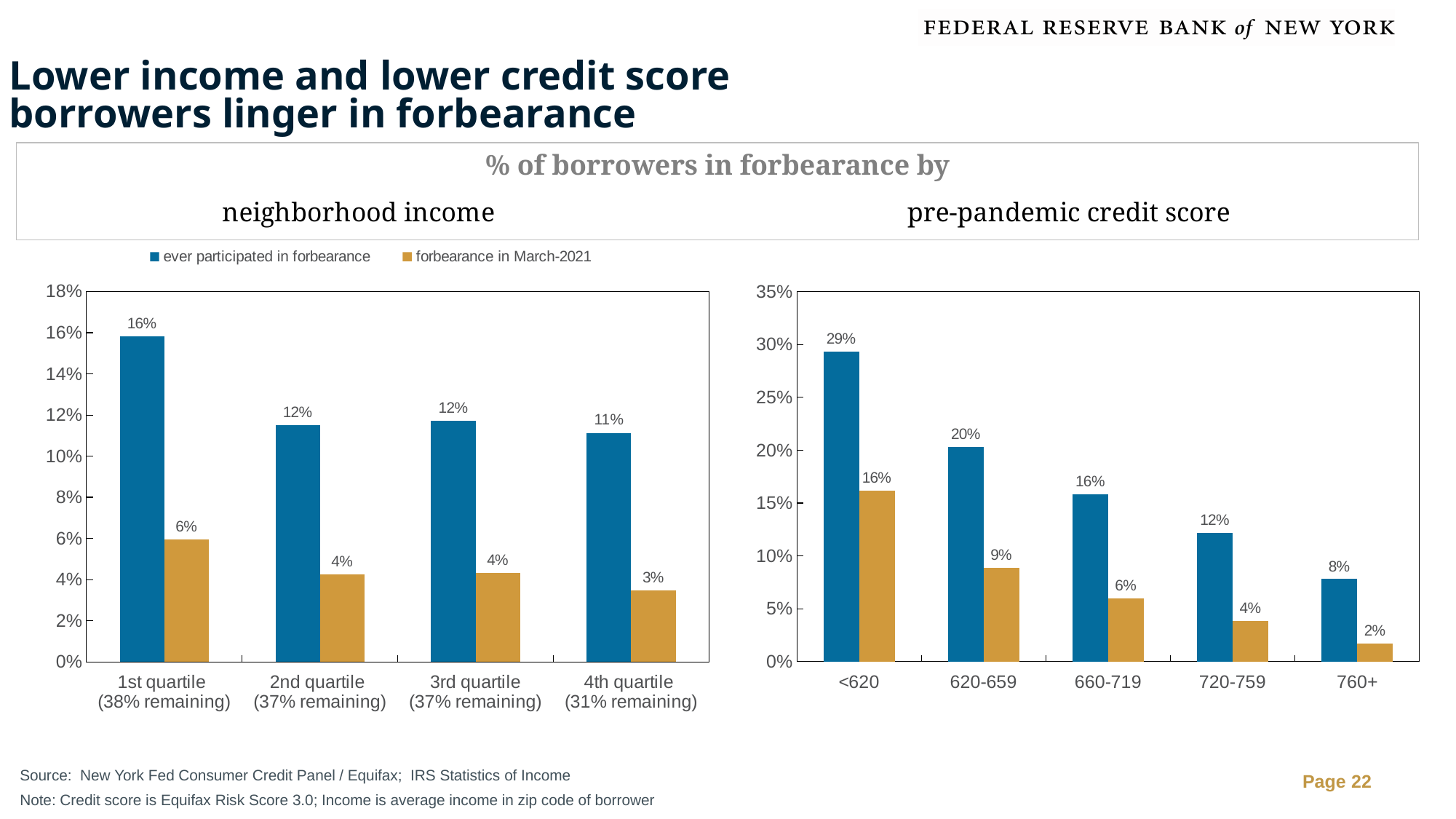
In the pre-pandemic credit score chart, do the ever participated in forbearance values rise or fall as credit score increases? fall In the neighborhood income chart, which quartile has the lowest forbearance in March-2021 value? 4th quartile In the neighborhood income chart, what percentage of 1st quartile borrowers ever participated in forbearance? 16% In the neighborhood income chart, what is the difference between the ever participated in forbearance values for the 1st quartile and the 4th quartile? 5% In the pre-pandemic credit score chart, which is larger: the forbearance in March-2021 value for 660-719 or for 720-759? 660-719 In the pre-pandemic credit score chart, which credit score group has the highest share of borrowers who ever participated in forbearance? <620 How many series does the legend list? 2 In the neighborhood income chart, what is the value for forbearance in March-2021 for the 4th quartile? 3% How many credit score groups are shown in the pre-pandemic credit score chart? 5 In the pre-pandemic credit score chart, what percentage of borrowers with a credit score below 620 ever participated in forbearance? 29% In the pre-pandemic credit score chart, what is the forbearance in March-2021 value for the 760+ group? 2% In the pre-pandemic credit score chart, what is the difference between the ever participated in forbearance value and the forbearance in March-2021 value for the 620-659 group? 11%